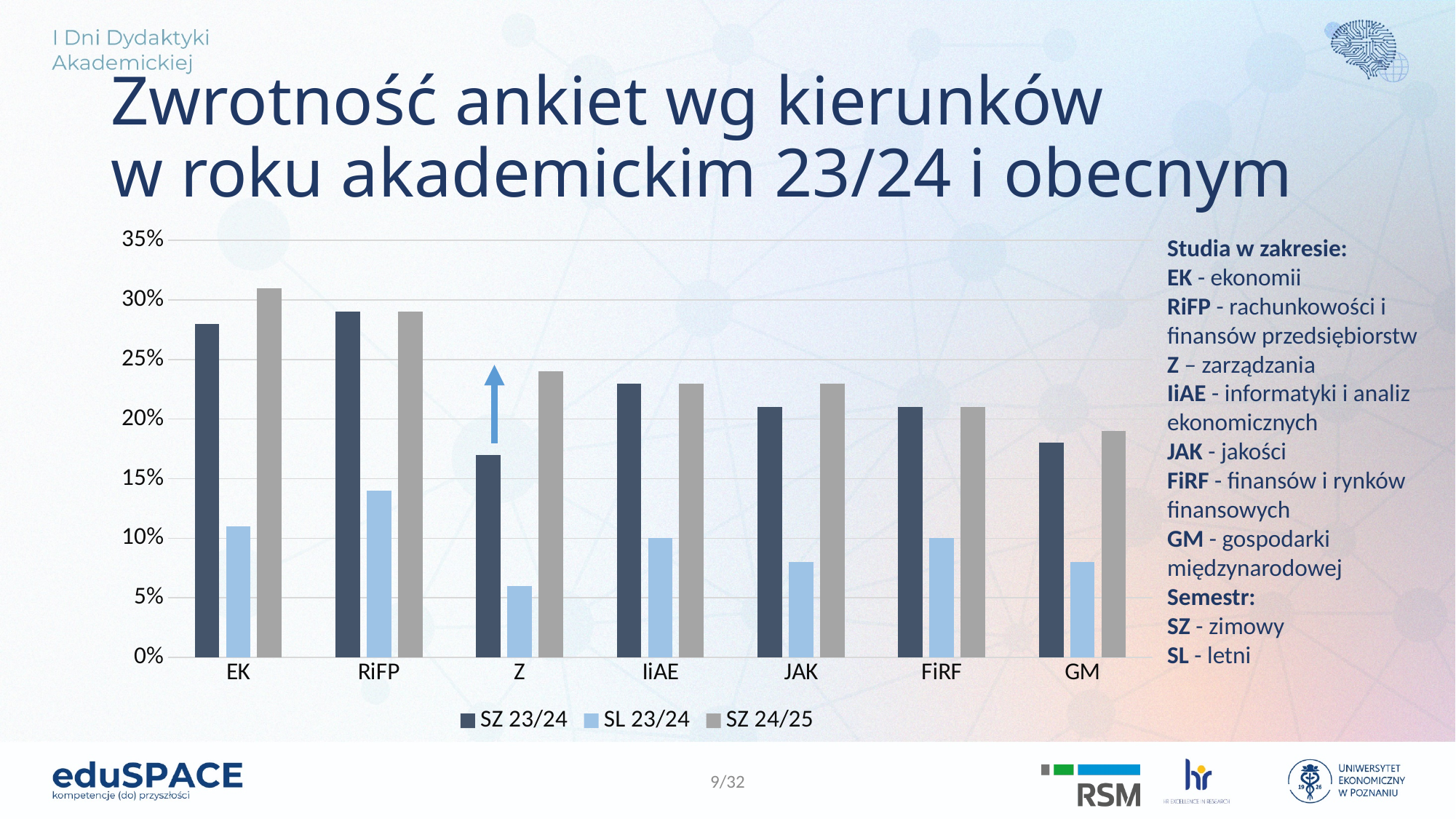
Is the SZ 23/24 value for GM greater or less than 20%? less Is the SZ 24/25 value for EK greater or less than 30%? greater Is the SL 23/24 value for Z greater or less than 10%? less What kind of chart is shown on the slide? bar chart Which programme has the highest SZ 24/25 value? EK Which programme has the lowest SZ 23/24 value? Z How many study programmes (categories) are shown on the x axis? 7 Which series is shown in light blue in the legend? SL 23/24 Which programme has the lowest SL 23/24 value? Z For RiFP, which is larger: the SL 23/24 value or the SZ 23/24 value? SZ 23/24 How many series does the legend list? 3 For Z, which is larger: the SZ 23/24 value or the SZ 24/25 value? SZ 24/25